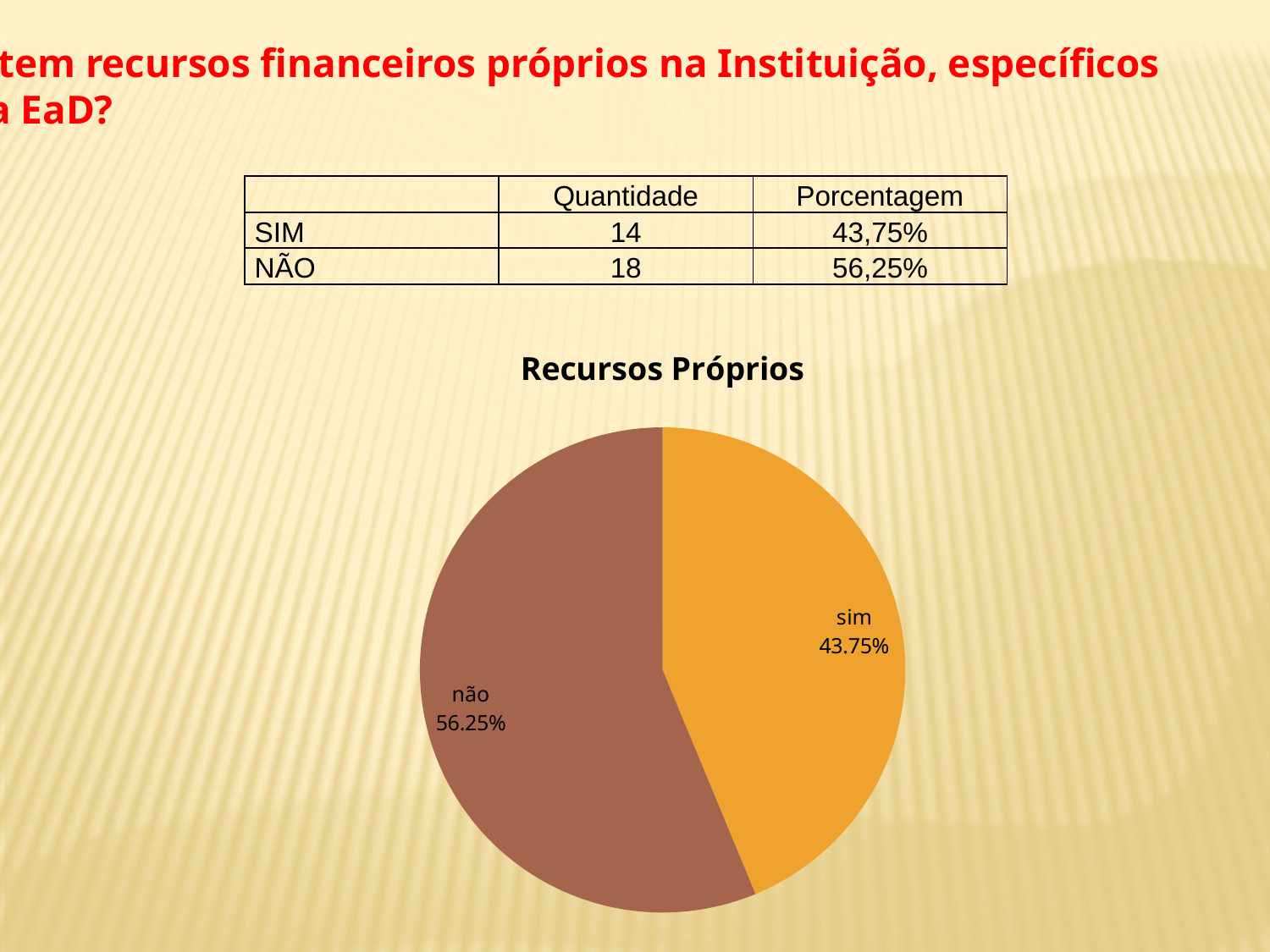
Is the share of the "sim" slice greater or less than 50%? less What kind of chart is shown on the slide? pie chart What share of the pie does the "sim" slice represent? 43.75% What is the title of the chart? Recursos Próprios Which slice of the pie is the smallest? sim How many slices does the pie chart have? 2 What colour is the "sim" slice of the pie? orange Which is larger, the "sim" slice or the "não" slice? não What share of the pie does the "não" slice represent? 56.25% What is the difference in percentage points between the "não" slice and the "sim" slice? 12.5% Which slice of the pie is the largest? não